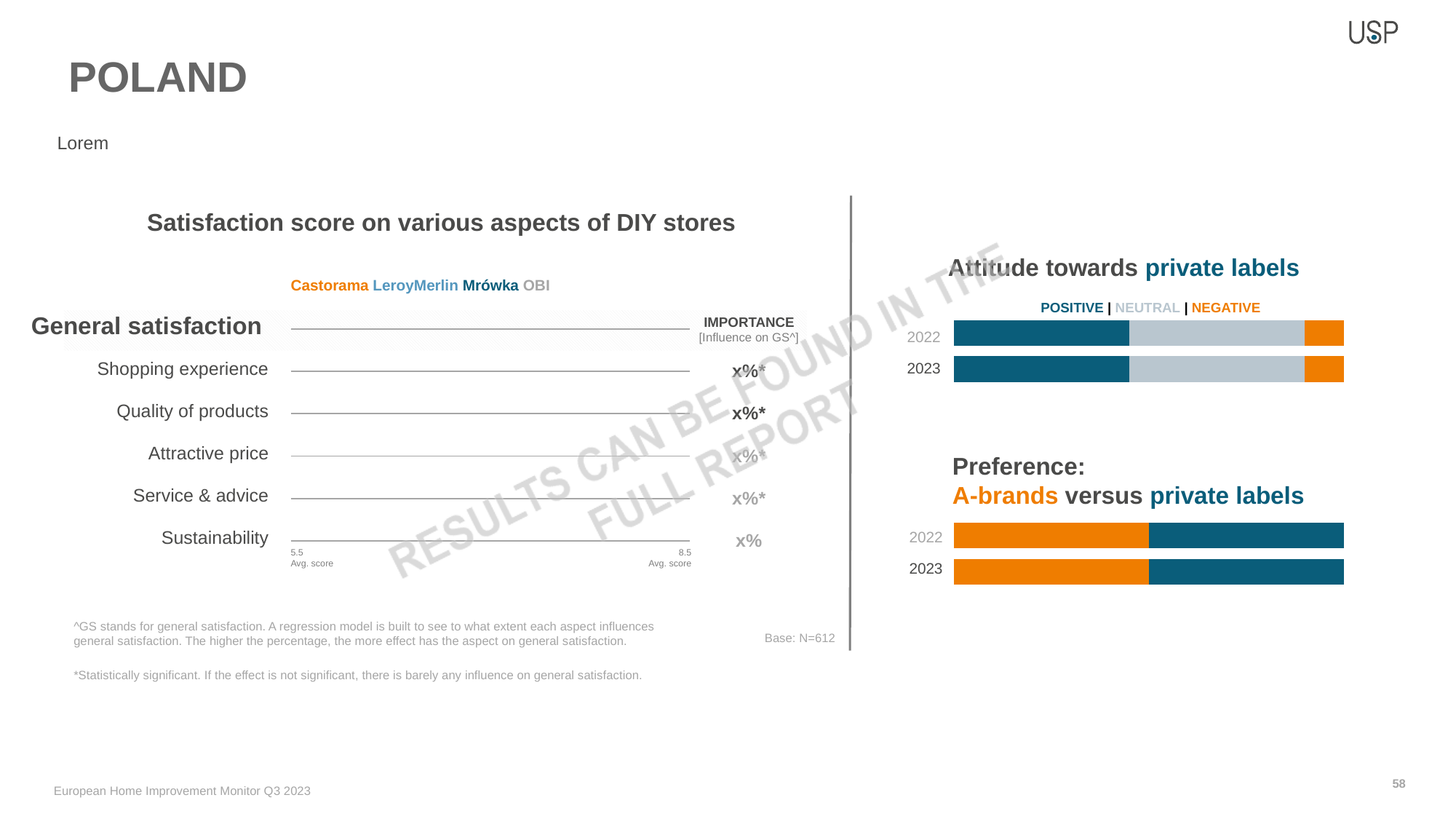
In the 'Attitude towards private labels' chart, which segment is larger for 2023: Positive or Negative? Positive How many aspects are listed below 'General satisfaction' in the 'Satisfaction score on various aspects of DIY stores' chart? 5 How many series are shown in the 'Preference: A-brands versus private labels' chart? 2 What kind of chart is the 'Attitude towards private labels' chart? bar chart How many series does the legend of the 'Attitude towards private labels' chart list? 3 In the 'Attitude towards private labels' chart, which segment is the smallest for 2022? Negative In the 'Attitude towards private labels' chart, which segment is larger for 2022: Neutral or Negative? Neutral Which years are shown in the 'Preference: A-brands versus private labels' chart? 2022 and 2023 What kind of chart is the 'Preference: A-brands versus private labels' chart? bar chart What are the legend entries of the 'Attitude towards private labels' chart? Positive, Neutral, Negative How many stores does the legend of the 'Satisfaction score on various aspects of DIY stores' chart list? 4 How many years are shown in the 'Attitude towards private labels' chart? 2